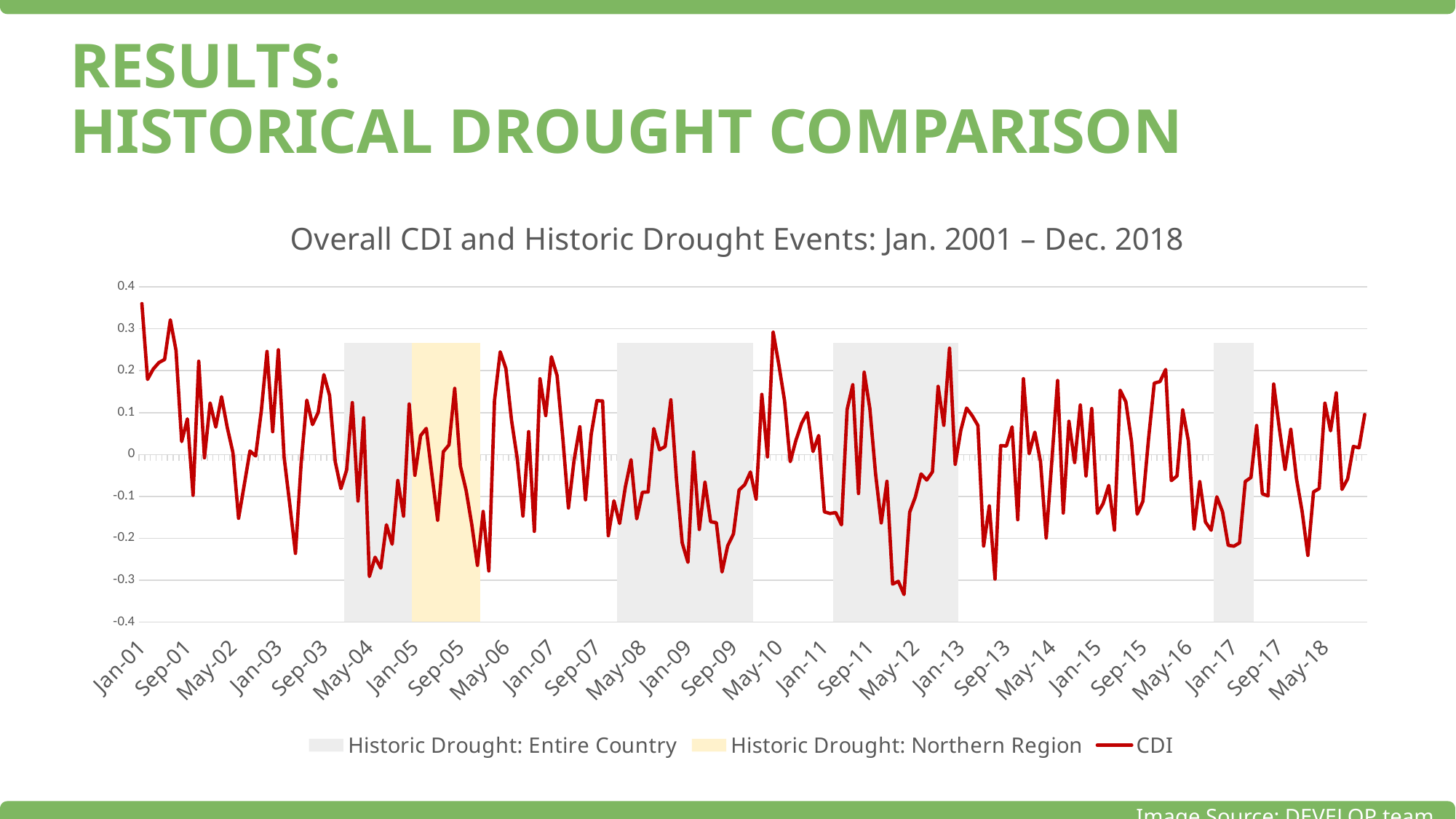
Which legend entry is shown in yellow shading? Historic Drought: Northern Region What is the maximum value shown on the y axis? 0.4 Is the CDI value at Jan-01 greater or less than 0.3? greater What is the minimum value shown on the y axis? -0.4 How many yellow shaded 'Historic Drought: Northern Region' periods are marked on the chart? 1 Is the highest CDI value on the chart greater or less than 0.3? greater How many entries does the chart legend list? 3 Is the lowest CDI value on the chart greater or less than -0.3? less What is the first x-axis label on the chart? Jan-01 What kind of chart is shown on the slide? line chart What is the title of the chart? Overall CDI and Historic Drought Events: Jan. 2001 – Dec. 2018 How many grey shaded 'Historic Drought: Entire Country' periods are marked on the chart? 4